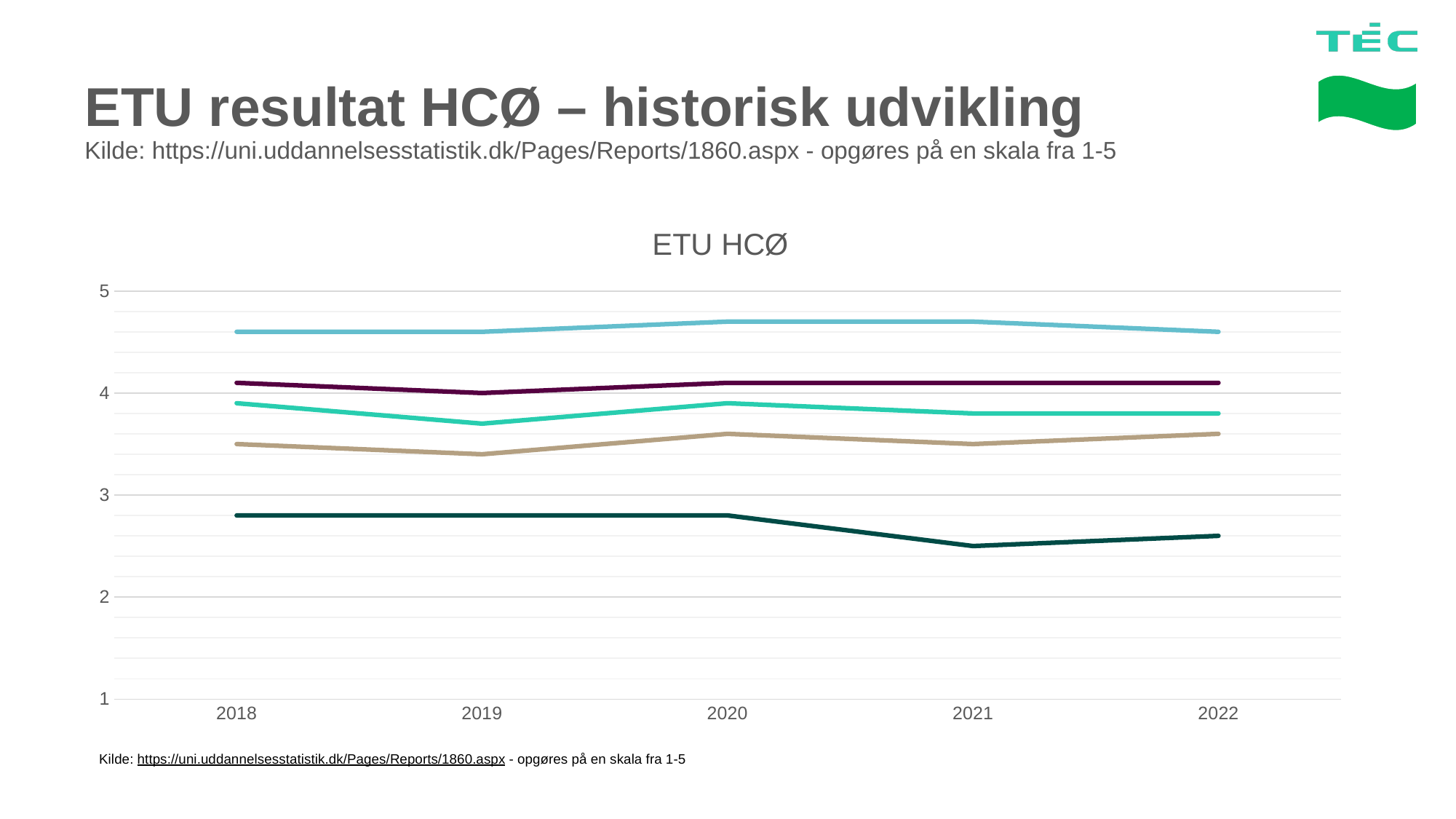
In 2018, which line has the higher value: the light blue line or the dark green line? the light blue line In which year does the dark green line reach its lowest value? 2021 How many years are shown on the x axis of the chart? 5 Does the dark green line rise or fall from 2020 to 2021? fall Is the value of the light blue line in 2020 greater or less than 4? greater What kind of chart is shown on the slide? line chart Is the value of the tan line in 2019 greater or less than 4? less Is the value of the dark green line in 2021 greater or less than 3? less How many lines are plotted in the chart? 5 What is the title of the chart? ETU HCØ In which year does the tan line reach its lowest value? 2019